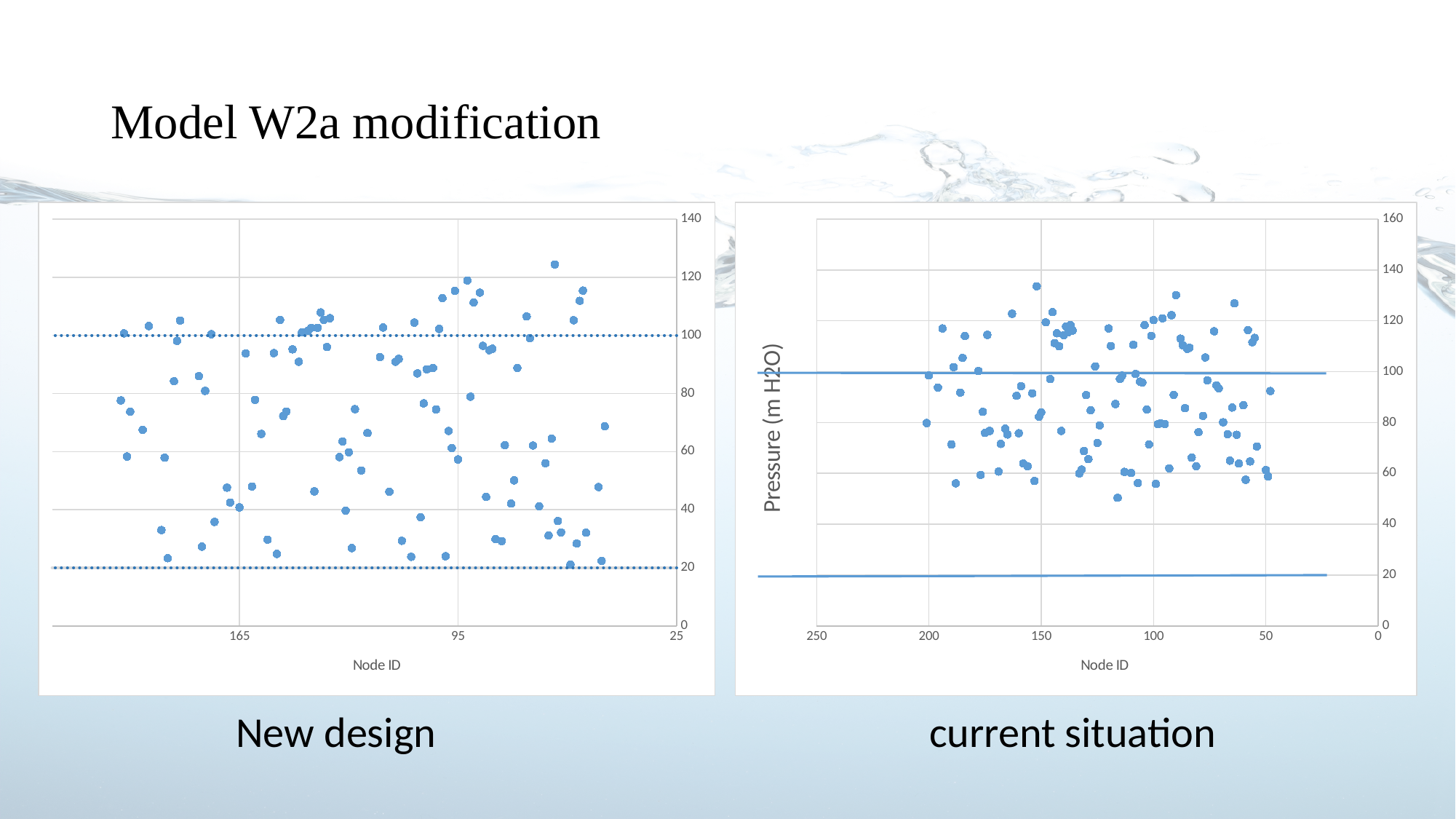
In the 'New design' chart on the left, is the highest plotted point greater or less than 120? greater In the 'current situation' chart on the right, is the highest plotted point greater or less than 140? less In the 'current situation' chart on the right, is the lower horizontal reference line greater or less than 40? less What kind of chart is the 'current situation' chart on the right? scatter chart In the 'New design' chart on the left, what is the label of the horizontal axis? Node ID What kind of chart is the 'New design' chart on the left? scatter chart In the 'current situation' chart on the right, what is the label of the vertical axis? Pressure (m H2O) In the 'New design' chart on the left, at what value on the vertical axis is the upper dotted reference line drawn? 100 In the 'New design' chart on the left, at what value on the vertical axis is the lower dotted reference line drawn? 20